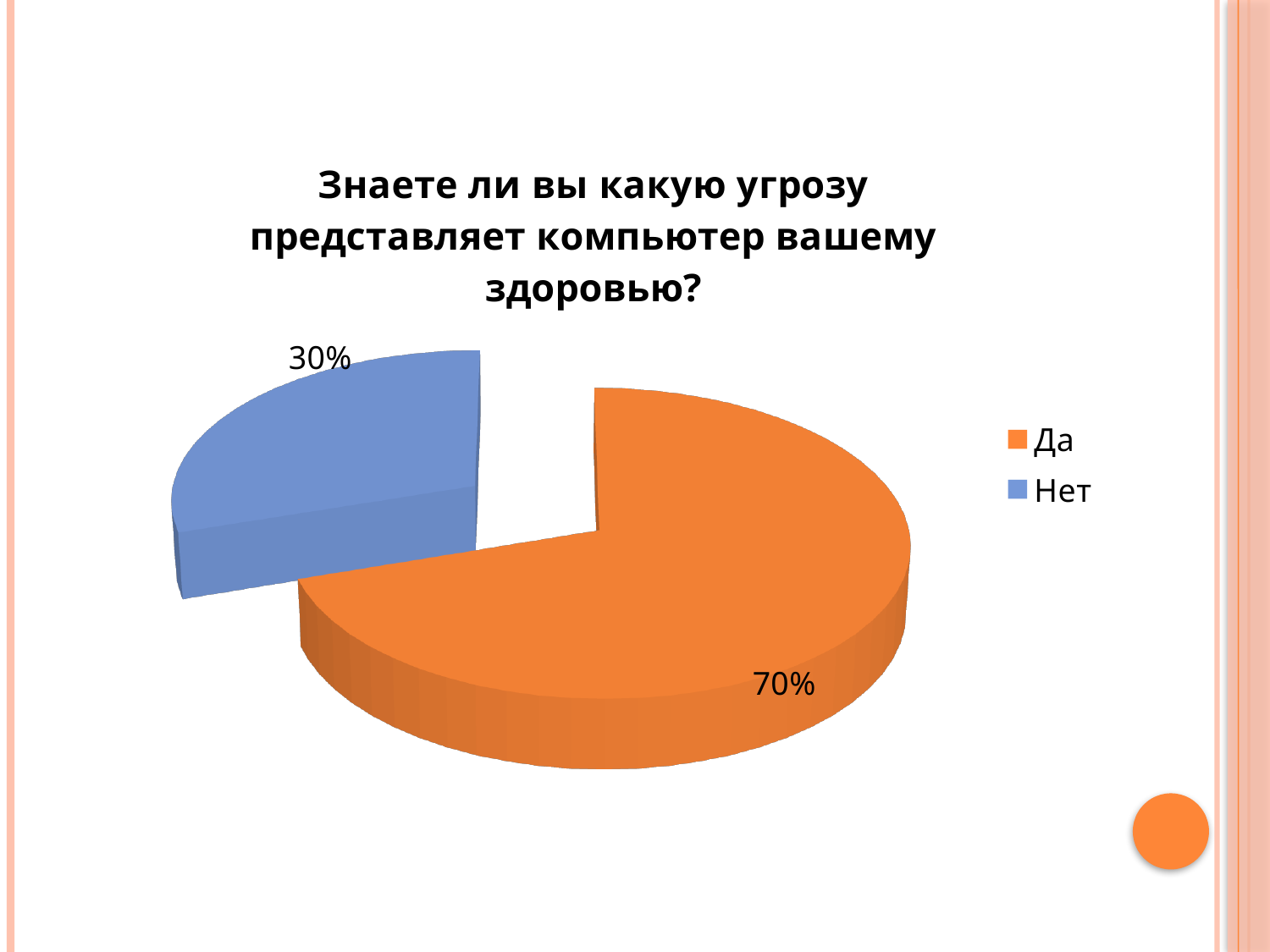
Which is larger, the value for "Да" or the value for "Нет"? Да How many categories does the pie chart have? 2 Which category has the largest slice? Да Which category has the smallest slice? Нет What colour is the "Да" slice? orange What kind of chart is shown on the slide? pie chart What is the value for "Да"? 70% What is the value for "Нет"? 30% What is the title of the chart? Знаете ли вы какую угрозу представляет компьютер вашему здоровью? What share of the pie does the "Нет" slice represent? 30% How many entries does the legend list? 2 What is the difference between the values for "Да" and "Нет"? 40%